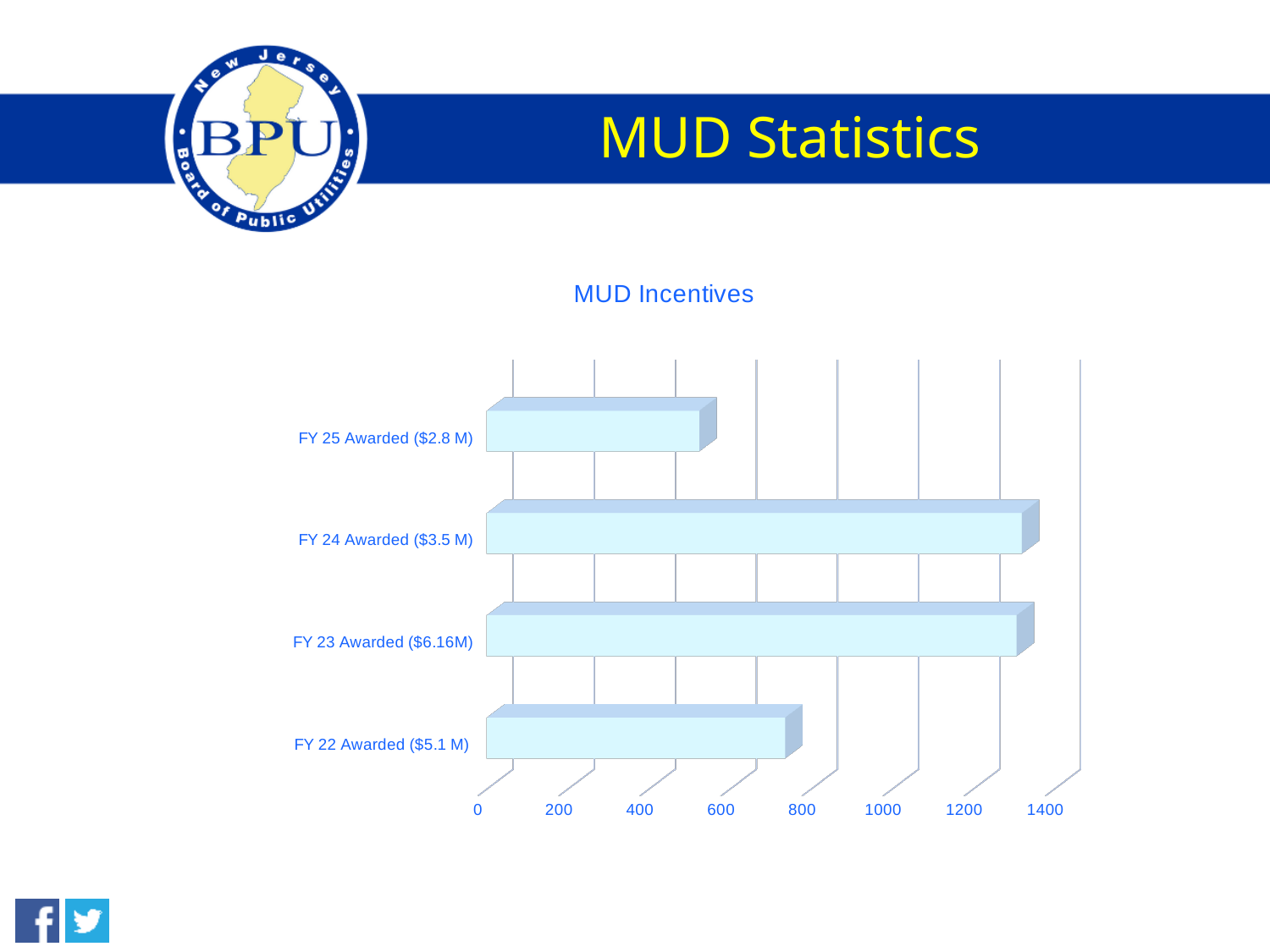
Which is larger, the value for FY 24 Awarded ($3.5 M) or FY 22 Awarded ($5.1 M)? FY 24 Awarded ($3.5 M) What dollar amount is shown in the category label for FY 23? $6.16M How many categories (bars) does the chart show? 4 Is the value for FY 24 Awarded ($3.5 M) greater or less than 1200? greater Is the value for FY 25 Awarded ($2.8 M) greater or less than 600? less Is the value for FY 22 Awarded ($5.1 M) greater or less than 800? less What is the title of the chart? MUD Incentives Which is larger, the value for FY 22 Awarded ($5.1 M) or FY 25 Awarded ($2.8 M)? FY 22 Awarded ($5.1 M) Which category has the lowest value? FY 25 Awarded ($2.8 M) What kind of chart is shown on the slide? bar chart